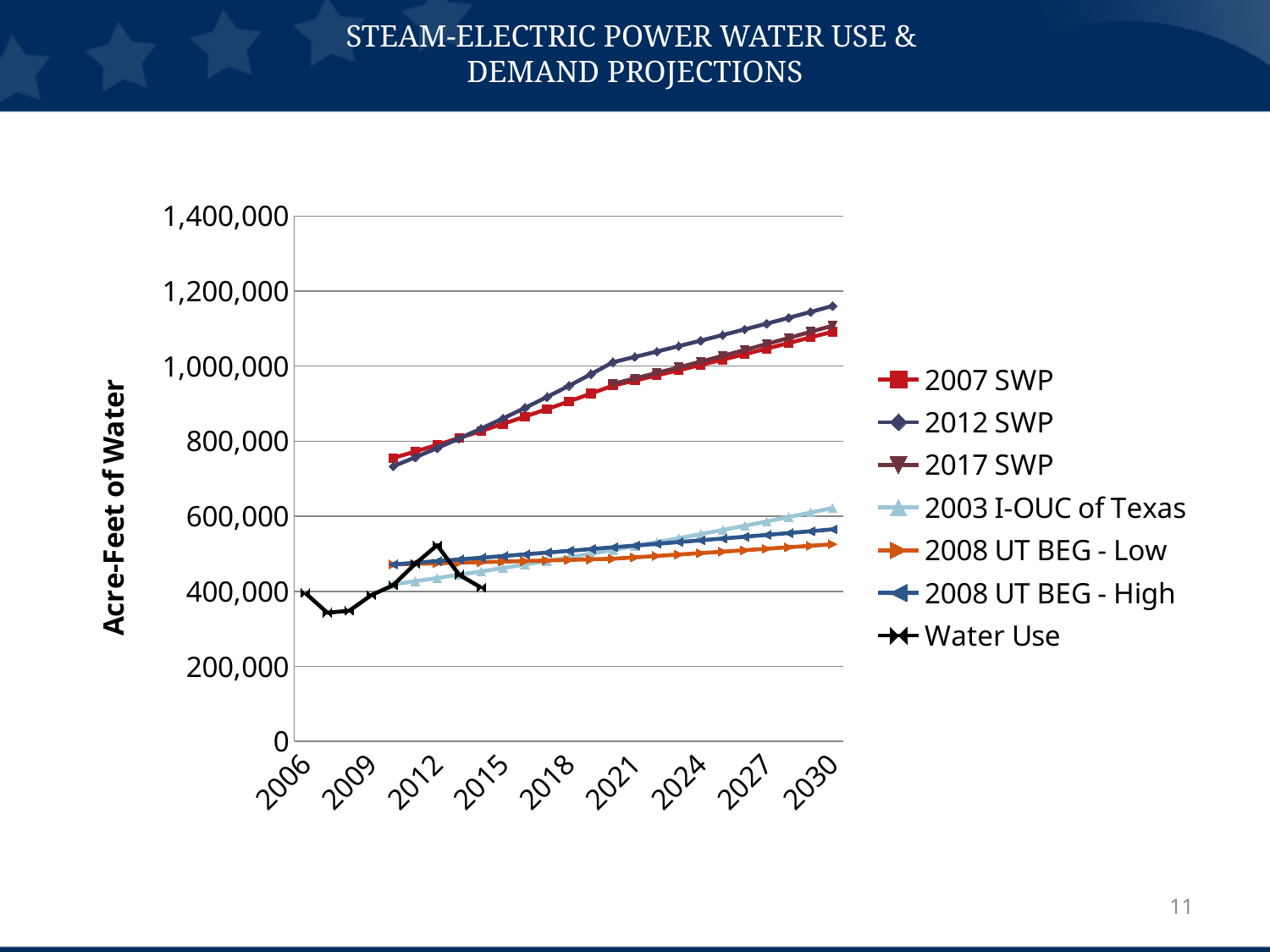
Is the value for 2003 I-OUC of Texas in 2030 greater or less than 800,000? less Among the projection series, which has the lowest value in 2030? 2008 UT BEG - Low Which series is plotted with a black line and x markers? Water Use How many series does the legend list? 7 Is the value for 2012 SWP in 2030 greater or less than 1,000,000? greater What is the label on the vertical axis of the chart? Acre-Feet of Water Which series has the highest value in 2030? 2012 SWP Does the 2007 SWP series rise or fall from 2010 to 2030? rise What kind of chart is shown on the slide? line chart Is the peak value of the Water Use series greater or less than 600,000? less In 2030, which is larger: 2012 SWP or 2008 UT BEG - High? 2012 SWP